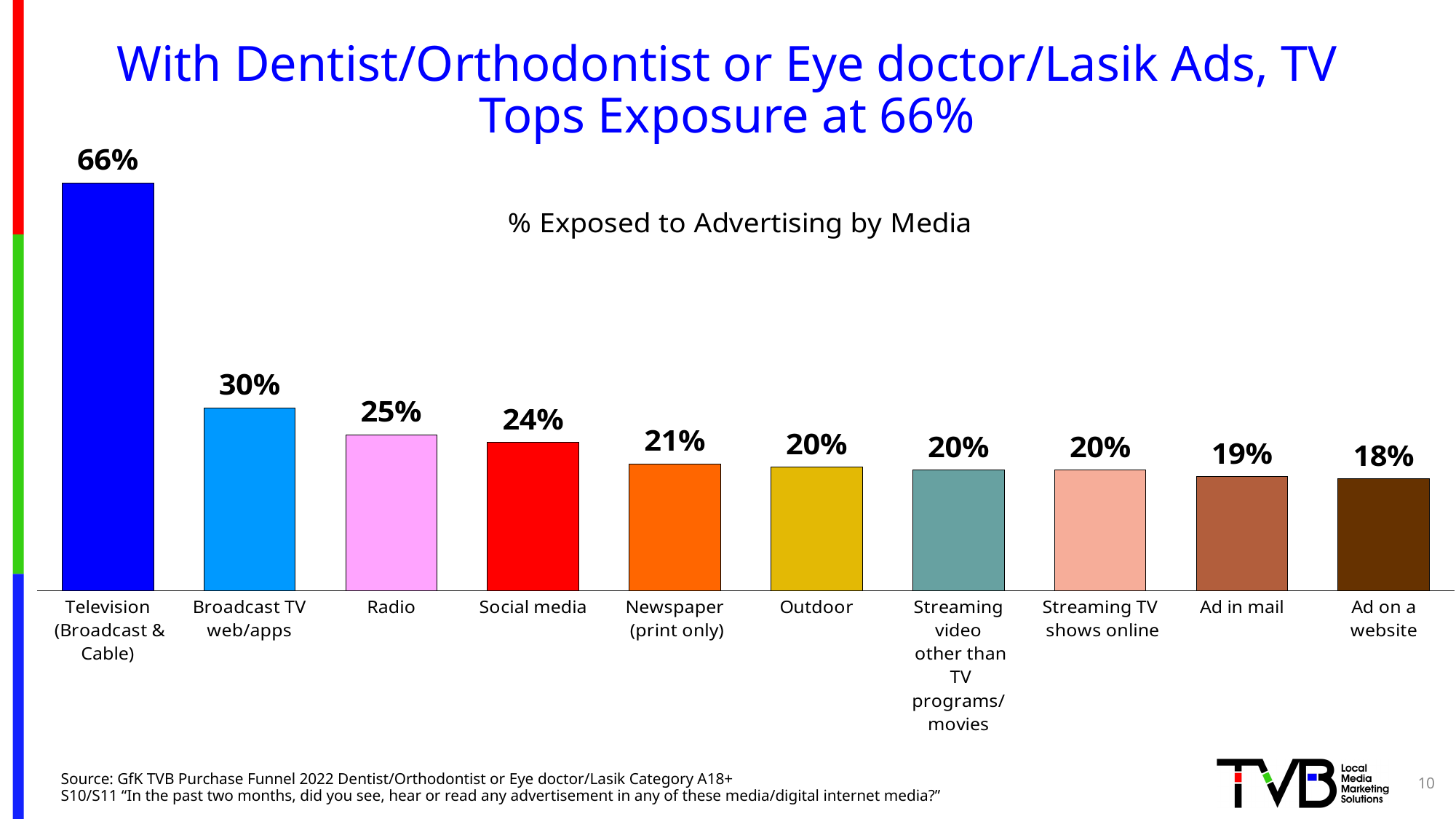
Which media category has the highest exposure percentage? Television (Broadcast & Cable) Which is larger, the value for Radio or the value for Outdoor? Radio What is the title of the chart? % Exposed to Advertising by Media Which media category has the lowest exposure percentage? Ad on a website What type of chart is shown on the slide? Bar chart What is the difference between the values for Social media and Ad in mail? 5 percentage points How many media categories are shown in the chart? 10 What percentage is shown for Newspaper (print only)? 21% What percentage is shown for Television (Broadcast & Cable)? 66% Do the values rise or fall moving from left to right across the categories? Fall What is the value for Radio? 25% What is the difference between the values for Television (Broadcast & Cable) and Broadcast TV web/apps? 36 percentage points